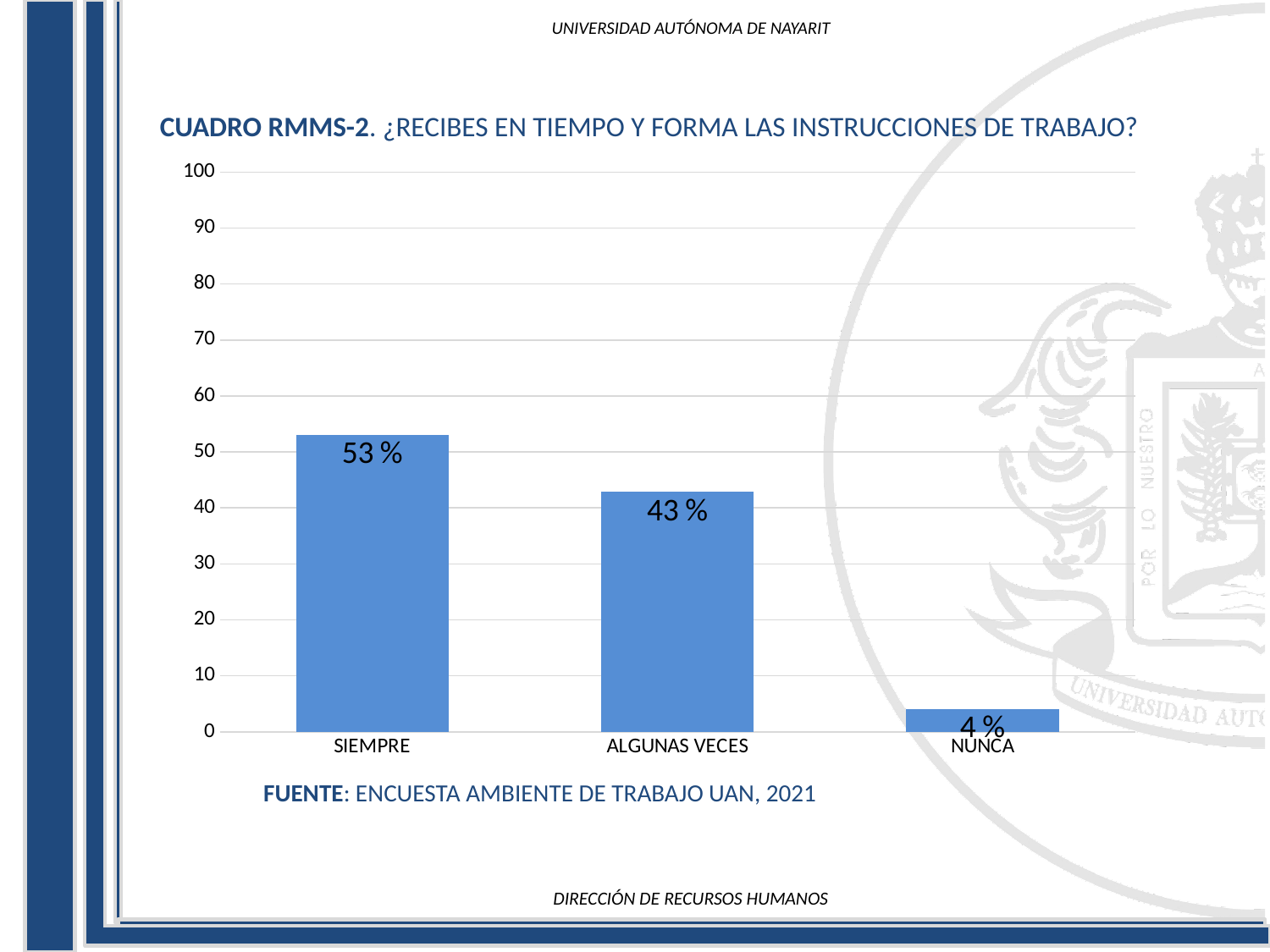
What kind of chart is shown on the slide? bar chart What is the difference between the values for SIEMPRE and ALGUNAS VECES? 10 % Which category has the lowest value? NUNCA Is the value for ALGUNAS VECES greater or less than 50? less Which category has the highest value? SIEMPRE What is the difference between the values for ALGUNAS VECES and NUNCA? 39 % What is the value for NUNCA? 4 % What is the value for ALGUNAS VECES? 43 % How many categories are shown on the x axis? 3 Which is larger, the value for SIEMPRE or the value for ALGUNAS VECES? SIEMPRE What source is cited below the chart? ENCUESTA AMBIENTE DE TRABAJO UAN, 2021 What is the value for SIEMPRE? 53 %